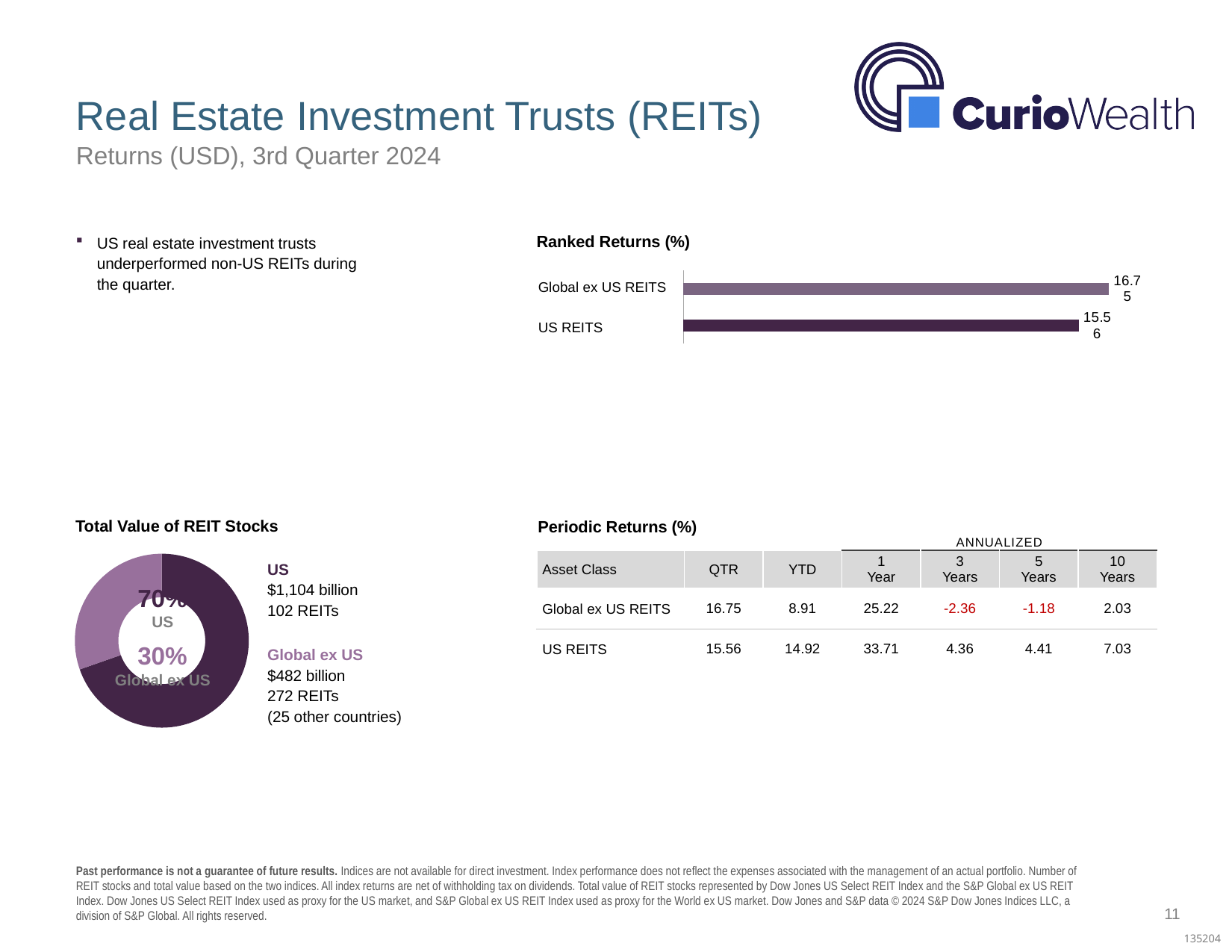
What kind of chart is the Total Value of REIT Stocks chart? Doughnut chart What kind of chart is the Ranked Returns (%) chart? Bar chart In the Total Value of REIT Stocks chart, what share does Global ex US represent? 30% In the Ranked Returns (%) chart, what is the difference between the Global ex US REITS and US REITS values? 1.19 In the Ranked Returns (%) chart, which is larger: the value for US REITS or for Global ex US REITS? Global ex US REITS In the Ranked Returns (%) chart, what is the value for Global ex US REITS? 16.75 In the Ranked Returns (%) chart, which category has the highest value? Global ex US REITS In the Total Value of REIT Stocks chart, which slice is the largest? US How many categories are shown in the Ranked Returns (%) chart? 2 In the Ranked Returns (%) chart, what is the value for US REITS? 15.56 In the Ranked Returns (%) chart, which category has the lowest value? US REITS In the Total Value of REIT Stocks chart, what share does US represent? 70%